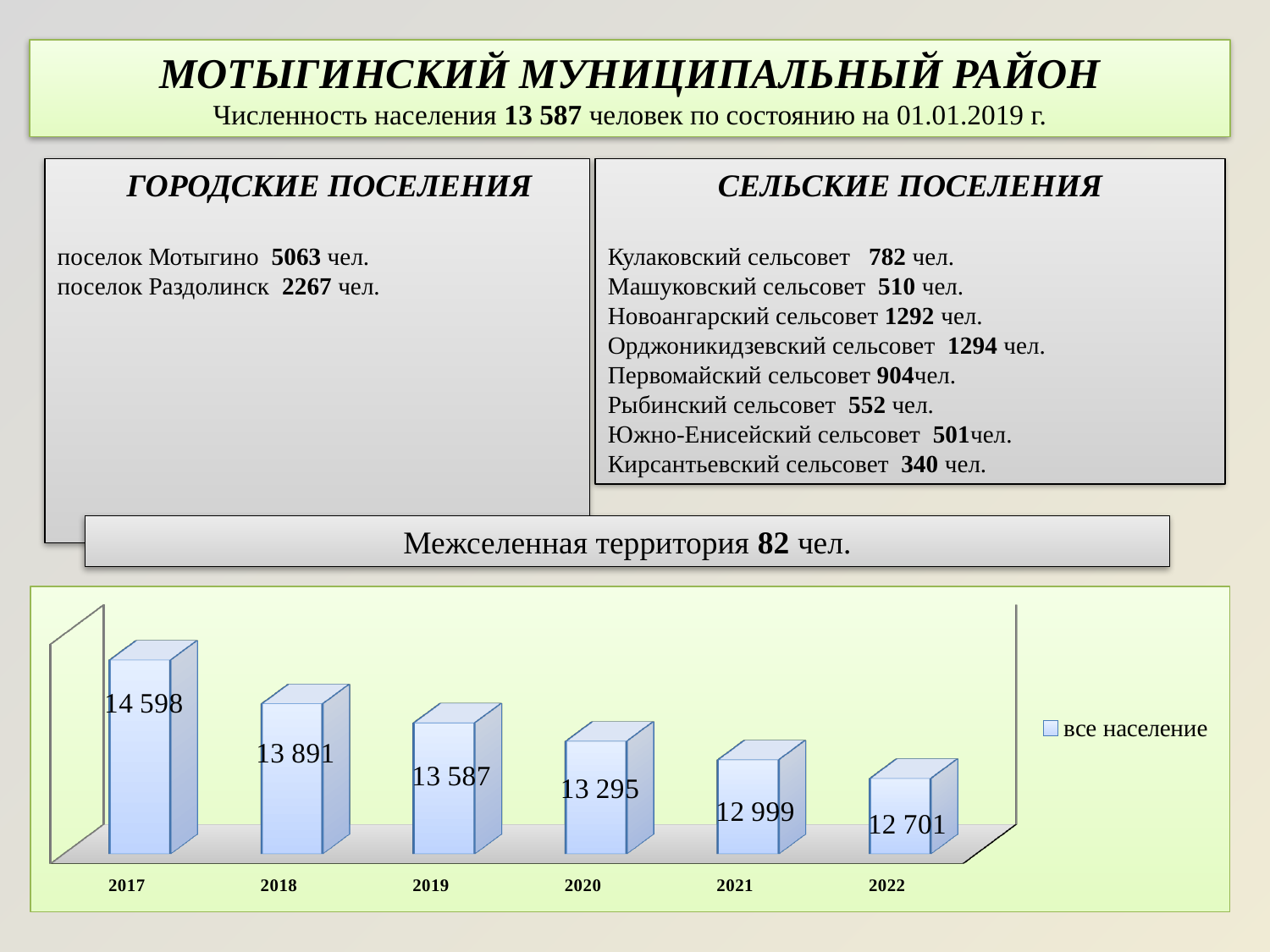
Which is larger, the value for 2020 or the value for 2021? 2020 Which year has the lowest value in the chart? 2022 What is the value for 2017 in the chart? 14 598 Do the values rise or fall from 2017 to 2022? fall What is the value for 2019 in the chart? 13 587 How many years are shown on the x axis of the chart? 6 What is the difference between the values for 2018 and 2019? 304 What is the value for 2022 in the chart? 12 701 Which year has the highest value in the chart? 2017 What is the difference between the values for 2017 and 2022? 1 897 How many series does the chart legend list? 1 What kind of chart is shown on the slide? bar chart